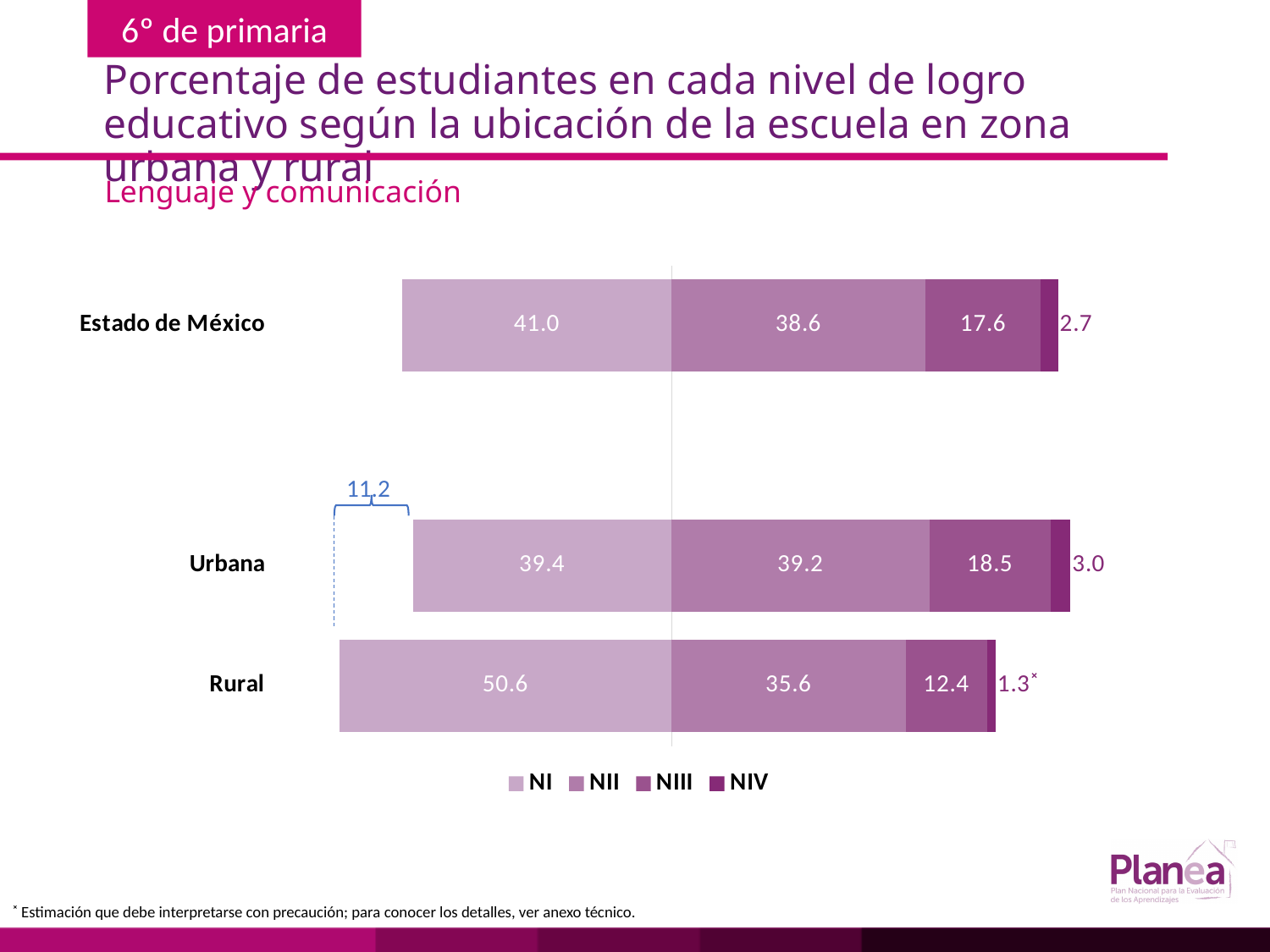
What is the difference between the NI values for Rural and Urbana? 11.2 Which is larger, the NIII value for Urbana or for Estado de México? Urbana What is the NIV value for Urbana? 3.0 What percentage of Rural students are at level NI? 50.6 Which category has the lowest NIV value? Rural How many categories are shown on the chart? 3 Which value on the chart is marked with an asterisk as an estimate to be interpreted with caution? 1.3 (Rural, NIV) What kind of chart is shown on the slide? Stacked bar chart What is the NIII value for Rural? 12.4 What is the NII value for Estado de México? 38.6 Which category has the highest NI value? Rural How many series does the legend list? 4